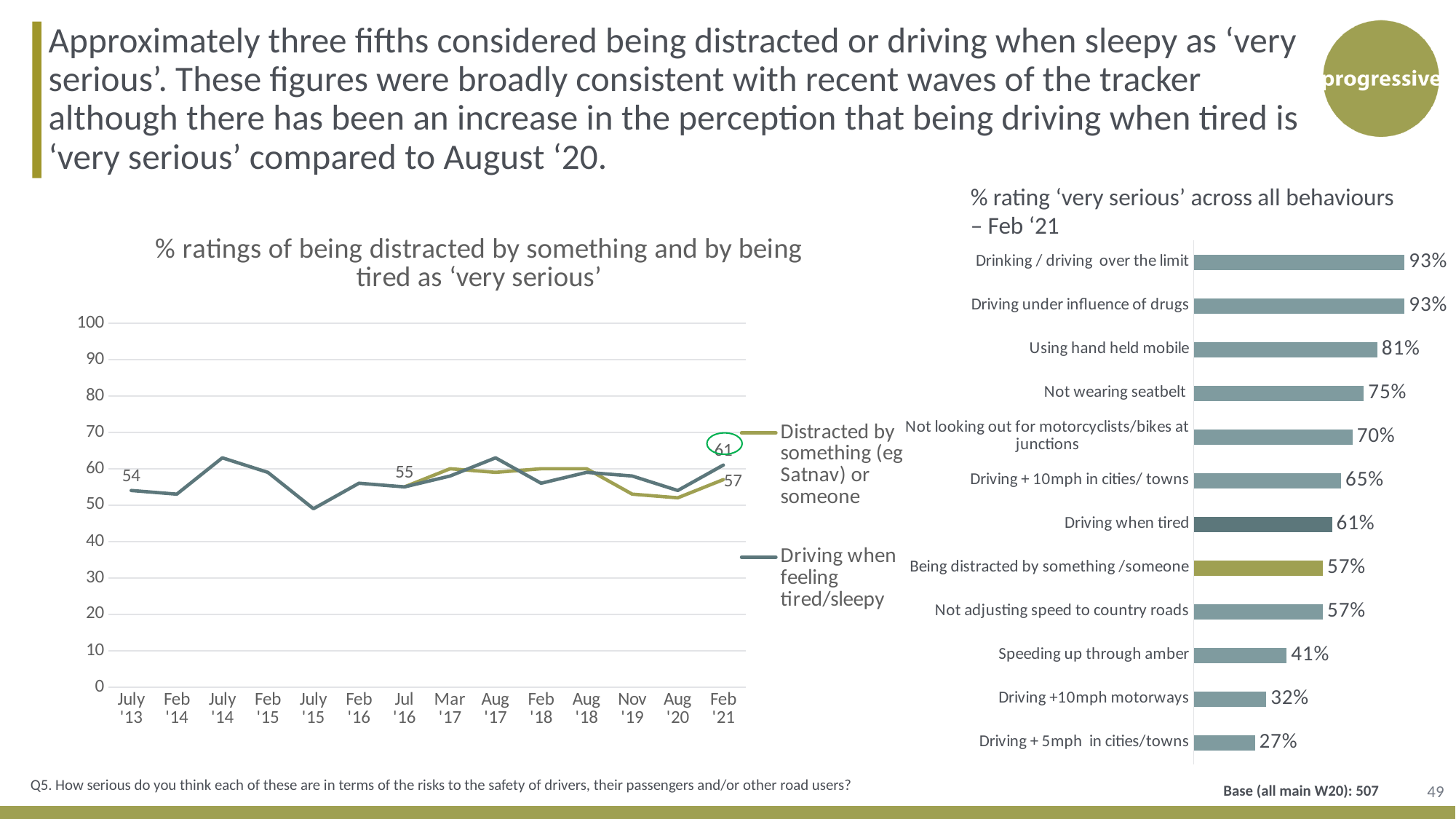
In the chart titled '% rating ‘very serious’ across all behaviours – Feb ‘21', which behaviour has the lowest value? Driving + 5mph in cities/towns In the chart titled '% rating ‘very serious’ across all behaviours – Feb ‘21', what is the difference between Driving when tired and Being distracted by something /someone? 4 percentage points In the line chart on the left, how many series does the legend list? 2 In the chart titled '% rating ‘very serious’ across all behaviours – Feb ‘21', what is the value for Speeding up through amber? 41% In the line chart on the left, what is the value for Driving when feeling tired/sleepy at July '13? 54 In the line chart on the left, what is the value for Distracted by something (eg Satnav) or someone at Feb '21? 57 In the line chart on the left, how many time points are shown on the x axis? 14 What kind of chart is the one titled '% rating ‘very serious’ across all behaviours – Feb ‘21'? Bar chart In the chart titled '% rating ‘very serious’ across all behaviours – Feb ‘21', what is the value for Using hand held mobile? 81% In the chart titled '% rating ‘very serious’ across all behaviours – Feb ‘21', which is larger: Not wearing seatbelt or Speeding up through amber? Not wearing seatbelt In the chart titled '% rating ‘very serious’ across all behaviours – Feb ‘21', how many behaviours are listed? 12 In the line chart on the left, what is the value for Driving when feeling tired/sleepy at Feb '21? 61